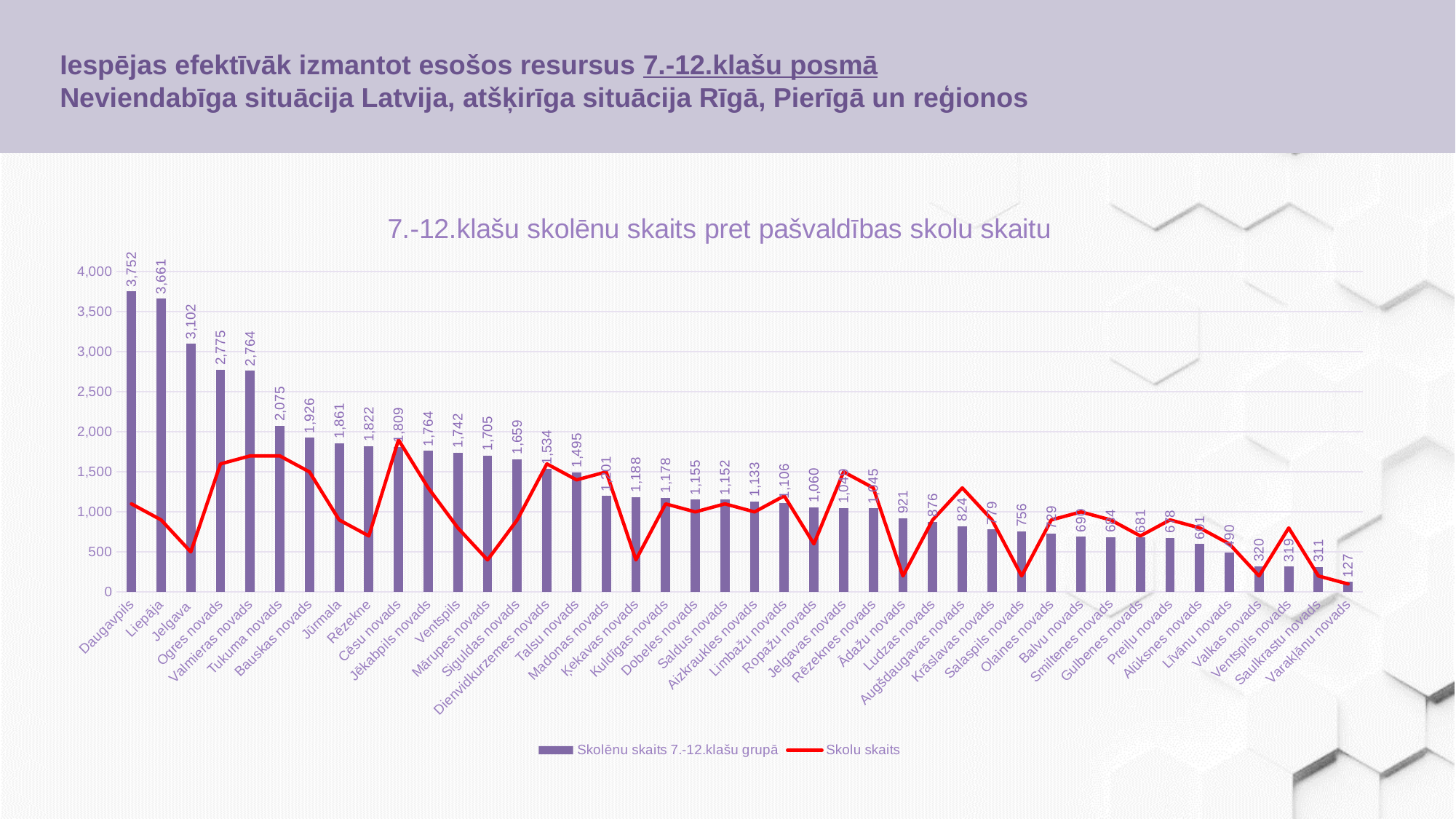
Which has more students in grades 7-12, Jelgava or Tukuma novads? Jelgava Which municipality has the lowest number of students in grades 7-12? Varakļānu novads What is the title of the chart? 7.-12.klašu skolēnu skaits pret pašvaldības skolu skaitu What is the difference in the number of students in grades 7-12 between Daugavpils and Liepāja? 91 How many series does the legend list? 2 What is the number of students in grades 7-12 for Ogres novads? 2,775 What is the number of students in grades 7-12 (Skolēnu skaits 7.-12.klašu grupā) for Daugavpils? 3,752 Do the bar values rise or fall from left to right along the x axis? fall Which municipality has the highest number of students in grades 7-12? Daugavpils What is the number of students in grades 7-12 for Varakļānu novads? 127 What is the number of students in grades 7-12 for Cēsu novads? 1,809 Is the number of students in grades 7-12 for Siguldas novads greater or less than 1,500? greater